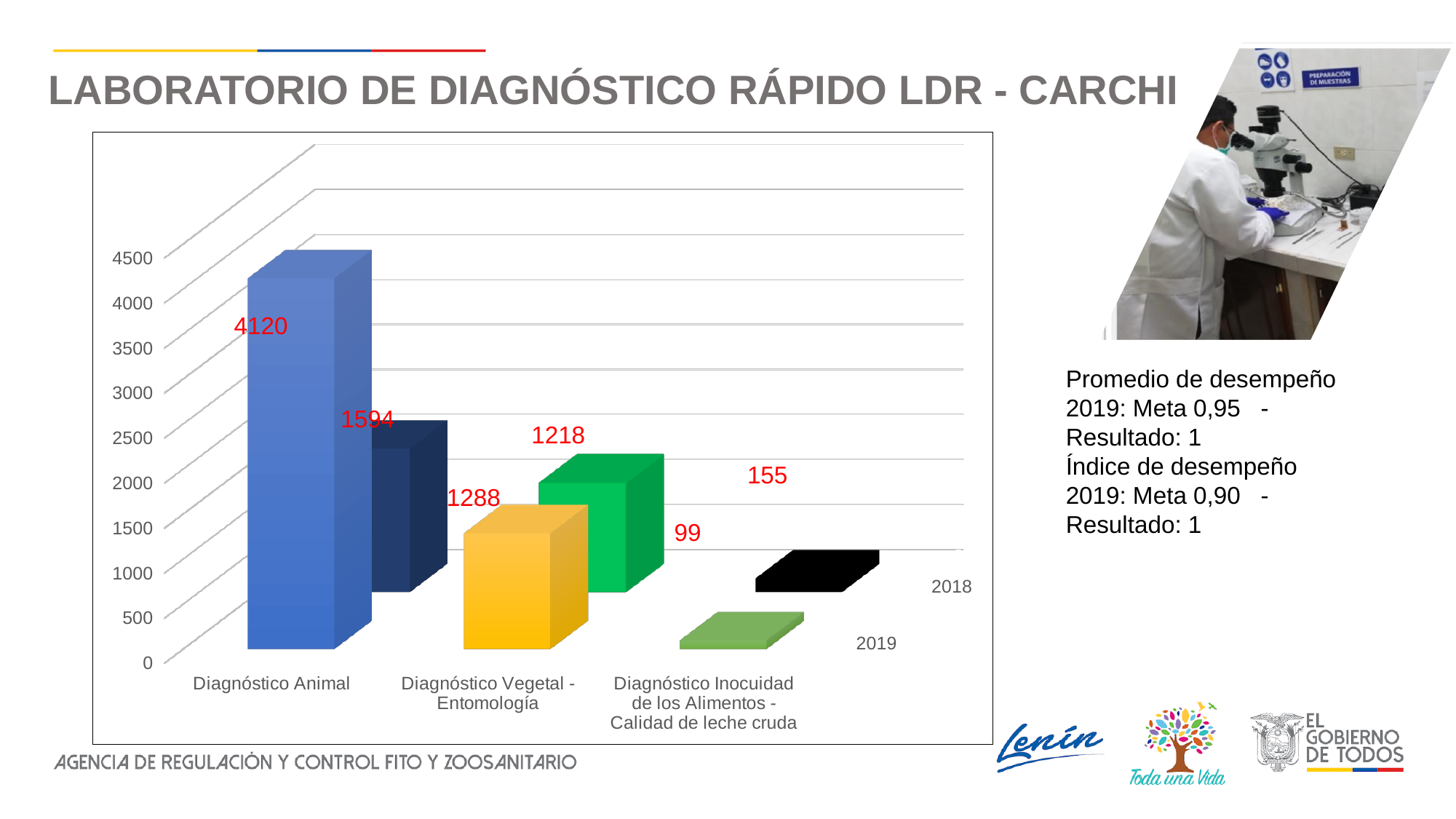
Which two years are plotted as series in the chart? 2018 and 2019 Which category has the lowest value in 2018? Diagnóstico Inocuidad de los Alimentos - Calidad de leche cruda Which category has the highest value in 2019? Diagnóstico Animal What type of chart is shown on the slide? bar chart What is the 2019 value for Diagnóstico Inocuidad de los Alimentos - Calidad de leche cruda? 99 How many categories are shown on the x axis of the chart? 3 What is the 2019 value for Diagnóstico Animal? 4120 What is the 2019 value for Diagnóstico Vegetal - Entomología? 1288 What is the 2018 value for Diagnóstico Animal? 1594 What is the 2018 value for Diagnóstico Inocuidad de los Alimentos - Calidad de leche cruda? 155 For Diagnóstico Inocuidad de los Alimentos - Calidad de leche cruda, which year has the larger value, 2018 or 2019? 2018 What is the difference between the 2019 and 2018 values for Diagnóstico Animal? 2526